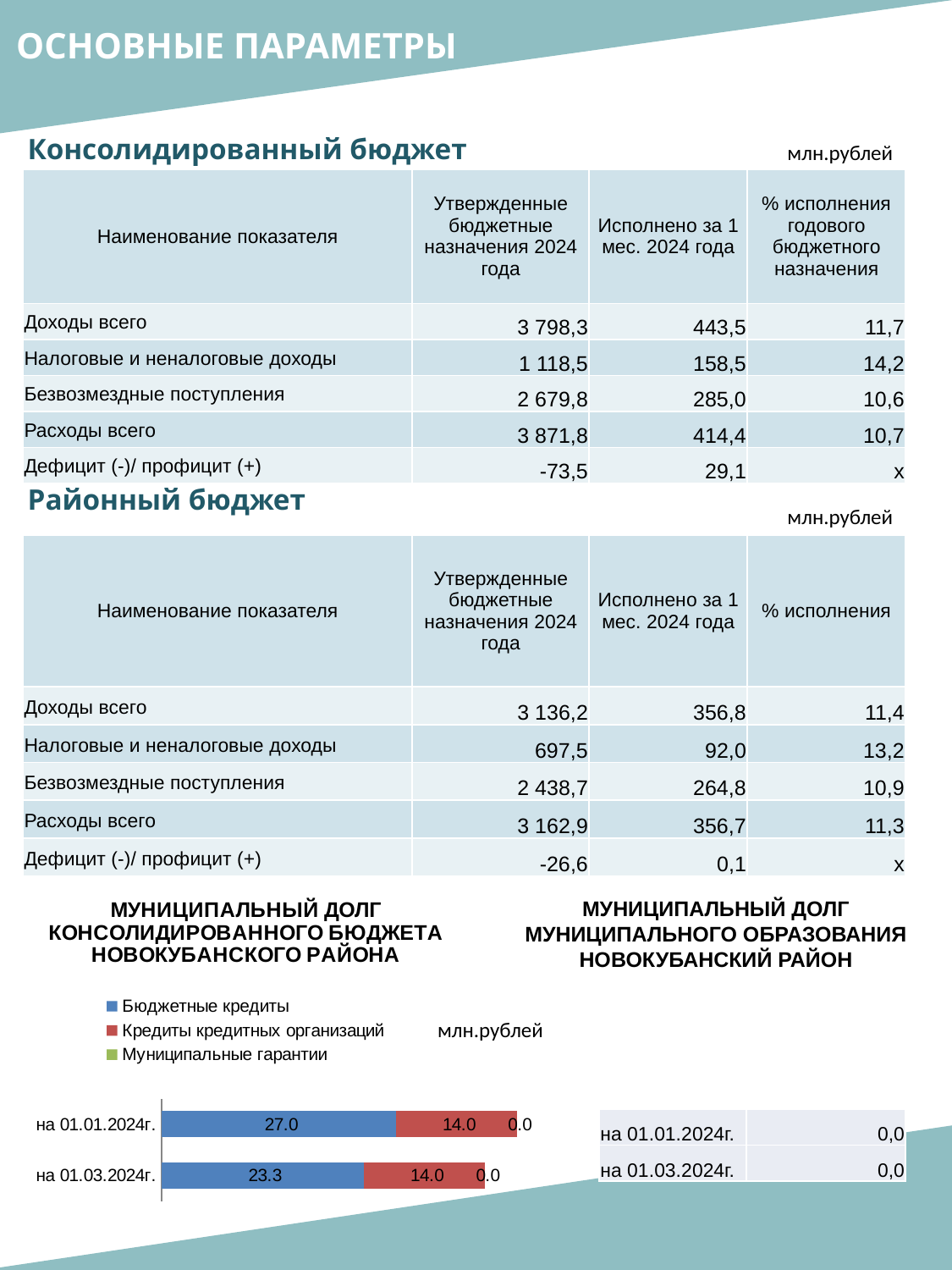
What unit is stated next to the legend of the municipal debt chart? млн.рублей In the municipal debt chart, what is the total of the stacked bar for 'на 01.03.2024г.'? 37.3 In the municipal debt chart, which date has the larger value for 'Бюджетные кредиты'? на 01.01.2024г. How many categories (dates) are shown in the municipal debt chart? 2 How many series does the legend of the municipal debt chart list? 3 What kind of chart is shown under the heading 'МУНИЦИПАЛЬНЫЙ ДОЛГ КОНСОЛИДИРОВАННОГО БЮДЖЕТА НОВОКУБАНСКОГО РАЙОНА'? Stacked bar chart In the municipal debt chart, what is the value of 'Бюджетные кредиты' for 'на 01.01.2024г.'? 27.0 In the municipal debt chart, what is the total of the stacked bar for 'на 01.01.2024г.'? 41.0 In the municipal debt chart, what is the value of 'Муниципальные гарантии' for 'на 01.01.2024г.'? 0.0 In the municipal debt chart, what is the difference in 'Бюджетные кредиты' between 'на 01.01.2024г.' and 'на 01.03.2024г.'? 3.7 In the municipal debt chart, what is the value of 'Кредиты кредитных организаций' for 'на 01.03.2024г.'? 14.0 In the municipal debt chart, what is the value of 'Бюджетные кредиты' for 'на 01.03.2024г.'? 23.3